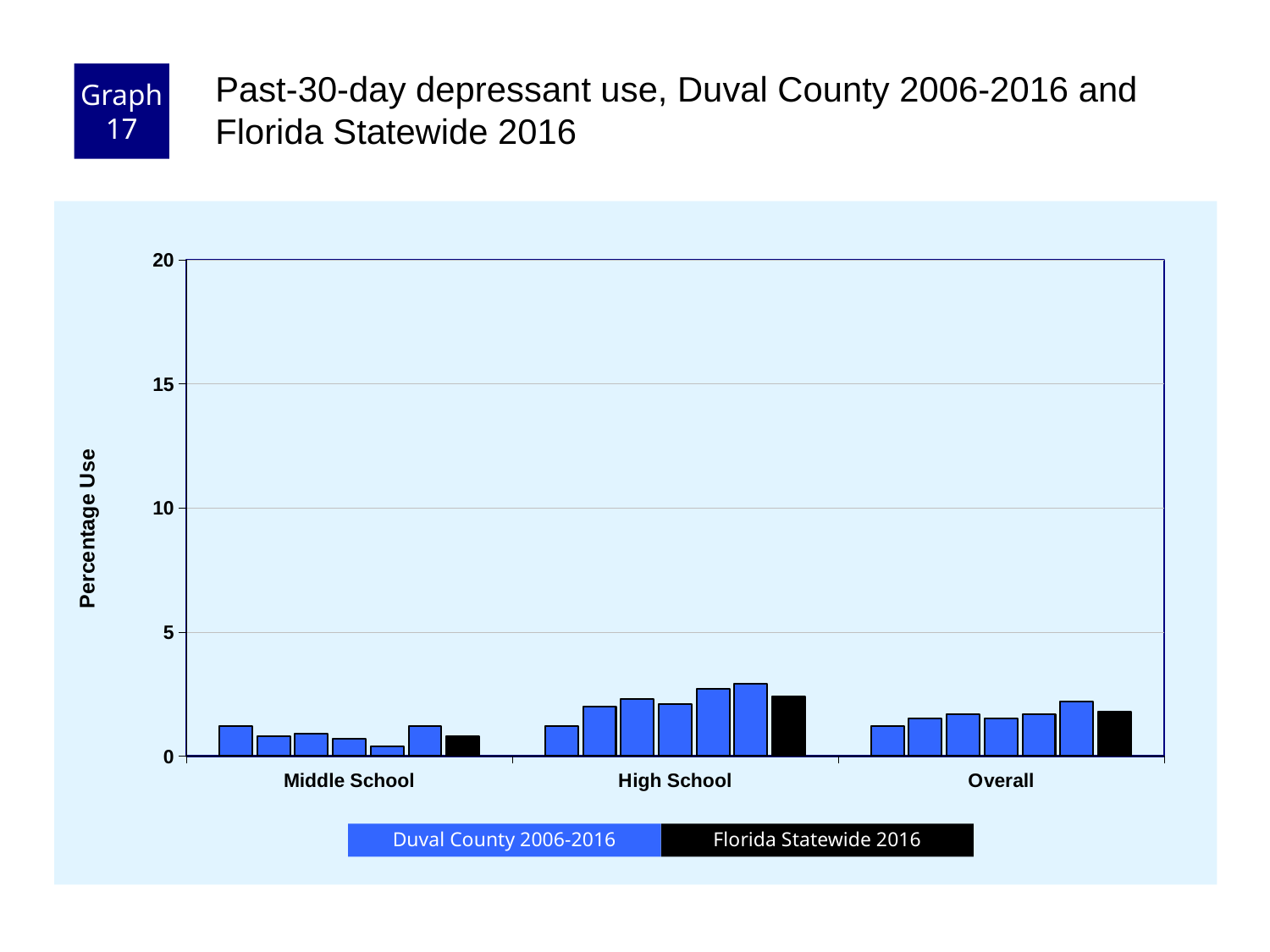
Which category has the lowest bar in the chart? Middle School Is the Florida Statewide 2016 value for High School greater or less than 5? less Is the Florida Statewide 2016 value for Middle School greater or less than 5? less Which colour represents Florida Statewide 2016 in the legend? black Which category has the tallest bar in the chart? High School What kind of chart is shown on the slide? bar chart Is the Florida Statewide 2016 bar larger for High School or for Middle School? High School How many series does the legend list? 2 Are all the bars for Overall greater or less than 5? less Is the Florida Statewide 2016 bar larger for Overall or for Middle School? Overall How many categories are shown on the x axis? 3 What is the label of the y axis? Percentage Use